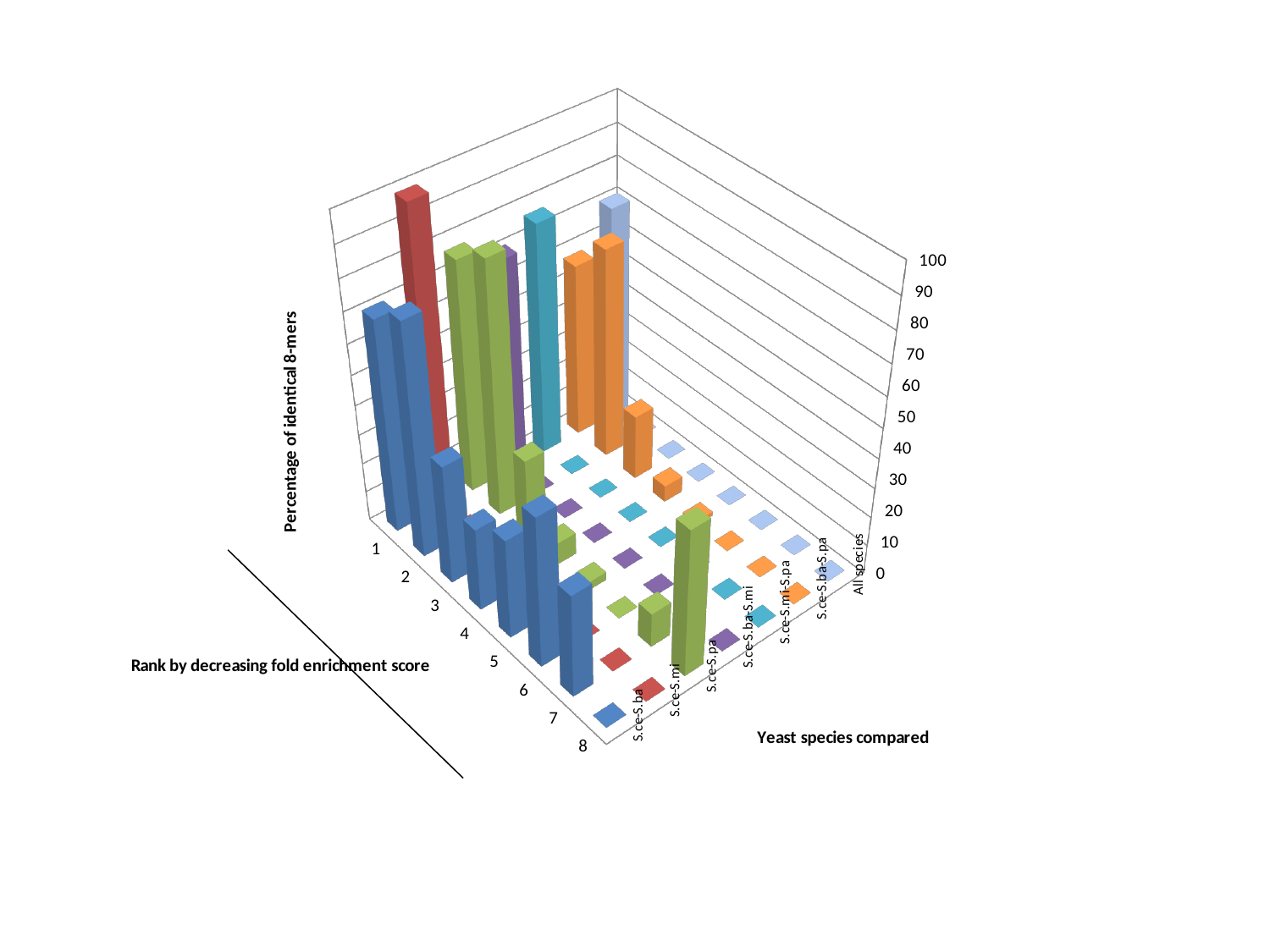
What is the title of the vertical axis? Percentage of identical 8-mers What kind of chart is shown on the slide? 3D bar chart Is the value for S.ce-S.ba at rank 1 greater or less than 50? greater Which is larger for S.ce-S.mi: the value at rank 1 or the value at rank 8? rank 1 How many yeast species comparisons are listed along the 'Yeast species compared' axis? 7 How many rank categories are shown along the 'Rank by decreasing fold enrichment score' axis? 8 What is the highest value shown on the vertical axis? 100 Is the value for S.ce-S.pa at rank 8 greater or less than 10? greater Which is larger for S.ce-S.ba: the value at rank 1 or the value at rank 8? rank 1 What is the title of the depth axis listing the species pairs? Yeast species compared Which species comparison is listed last (furthest back) on the 'Yeast species compared' axis? All species Is the value for All species at rank 8 greater or less than 10? less